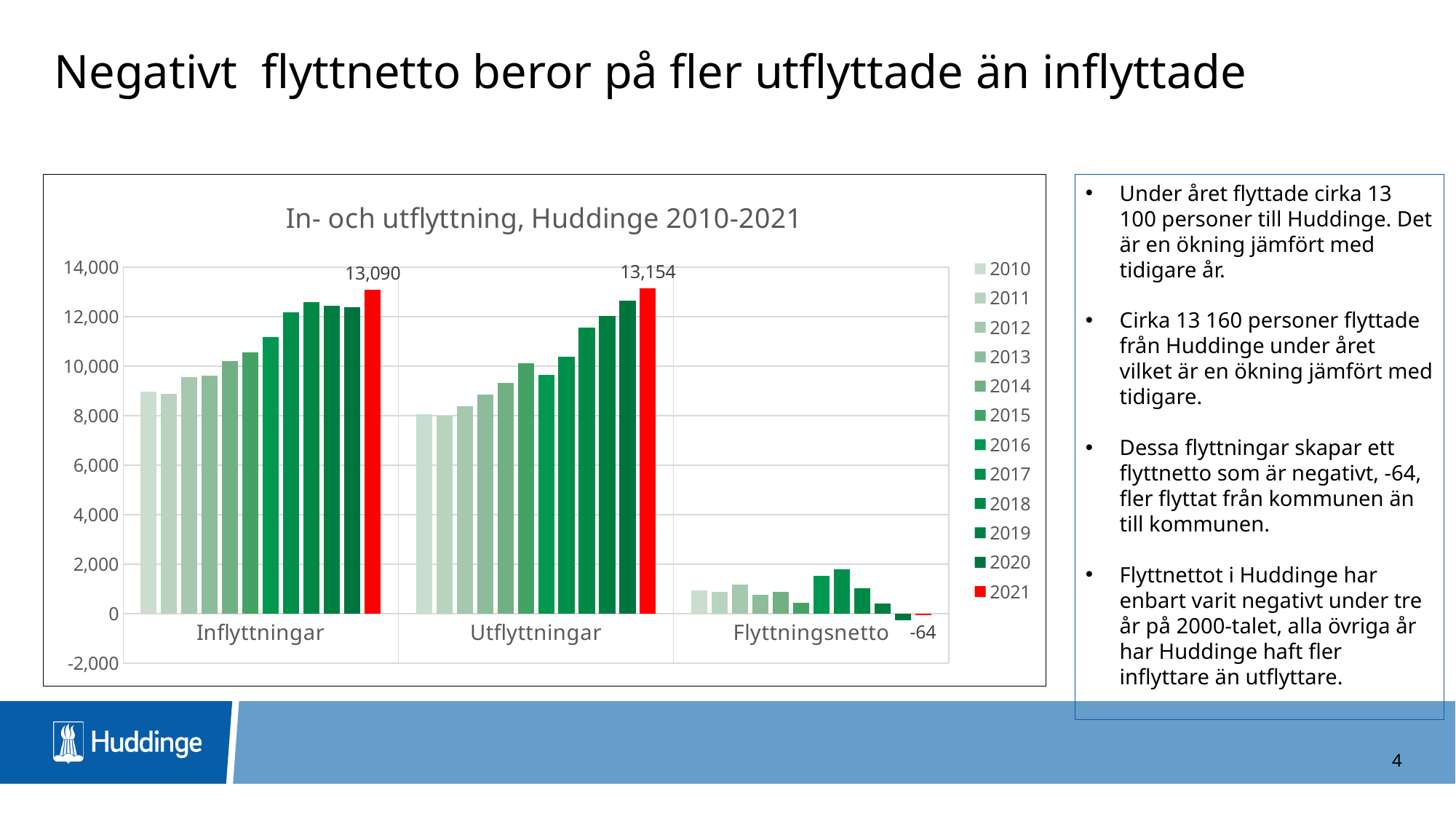
Is the value for Utflyttningar in 2018 greater or less than 12,000? less Is the value for Inflyttningar in 2010 greater or less than 10,000? less What is the difference between Utflyttningar and Inflyttningar in 2021? 64 What is the value for Flyttningsnetto in 2021? -64 How many series does the legend list? 12 Do the Inflyttningar values rise or fall from 2010 to 2021? Rise In 2021, which is larger: Inflyttningar or Utflyttningar? Utflyttningar What kind of chart is shown? Bar chart What is the value for Utflyttningar in 2021? 13,154 What is the value for Inflyttningar in 2021? 13,090 How many categories are shown on the x axis? 3 Which year has the highest Flyttningsnetto? 2017